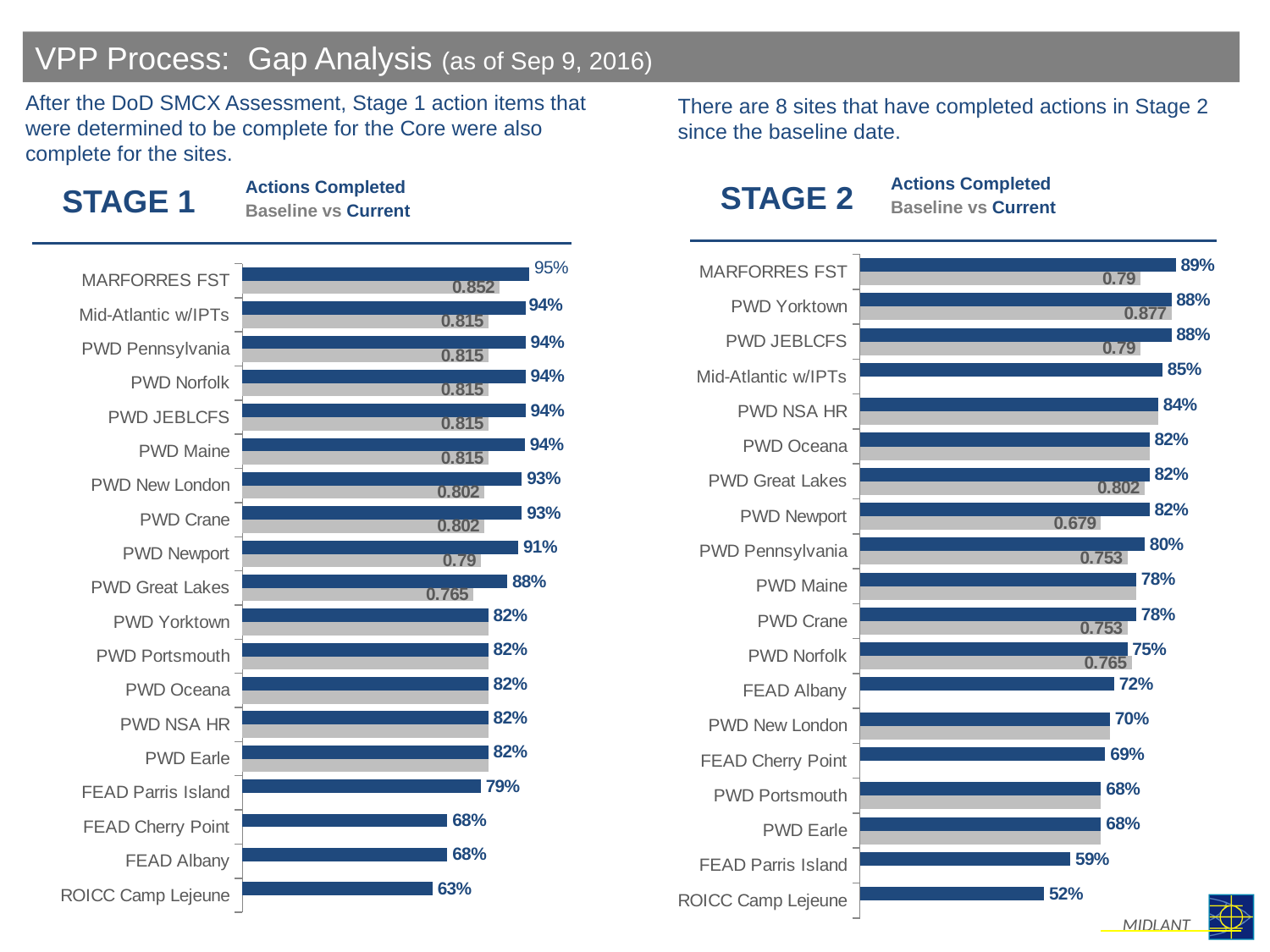
In the Stage 2 chart, which site has the highest current actions completed value? MARFORRES FST In the Stage 1 chart, which colour represents the current values? Blue In the Stage 1 chart, which site has the lowest current actions completed value? ROICC Camp Lejeune In the Stage 2 chart, which has the larger current value, FEAD Albany or PWD New London? FEAD Albany In the Stage 2 chart, what is the baseline value shown for PWD Yorktown? 0.877 In the Stage 1 chart, how many sites are listed? 19 In the Stage 1 chart, what is the difference between the current values for PWD Newport and FEAD Parris Island? 12% In the Stage 2 chart, what is the current actions completed value for PWD Newport? 82% In the Stage 2 chart, what is the difference between the current values for MARFORRES FST and ROICC Camp Lejeune? 37% What type of chart is used for the Stage 2 data? Bar chart In the Stage 1 chart, what is the baseline value shown for PWD Great Lakes? 0.765 In the Stage 1 chart, what is the current actions completed value for MARFORRES FST? 95%